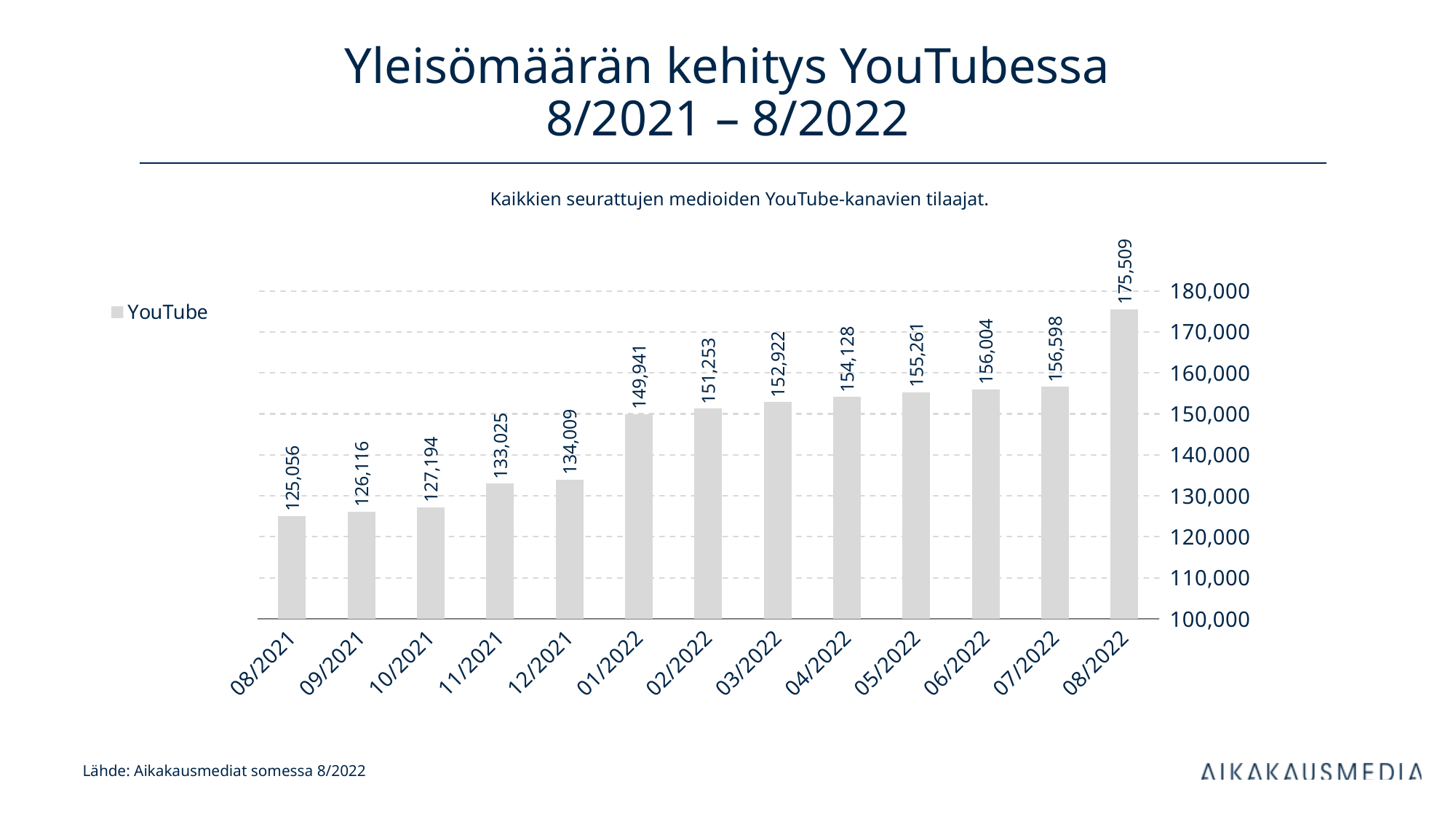
What is the value for 08/2022? 175,509 Do the values rise or fall from 08/2021 to 08/2022? rise How many months are shown on the x axis? 13 What is the value for 08/2021? 125,056 Which month has the lowest value? 08/2021 Is the value for 12/2021 greater or less than 140,000? less Which is larger, the value for 11/2021 or the value for 03/2022? 03/2022 What is the value for 01/2022? 149,941 Which month has the highest value? 08/2022 What kind of chart is shown on the slide? bar chart What is the difference between the values for 08/2022 and 08/2021? 50,453 What is the difference between the values for 01/2022 and 12/2021? 15,932